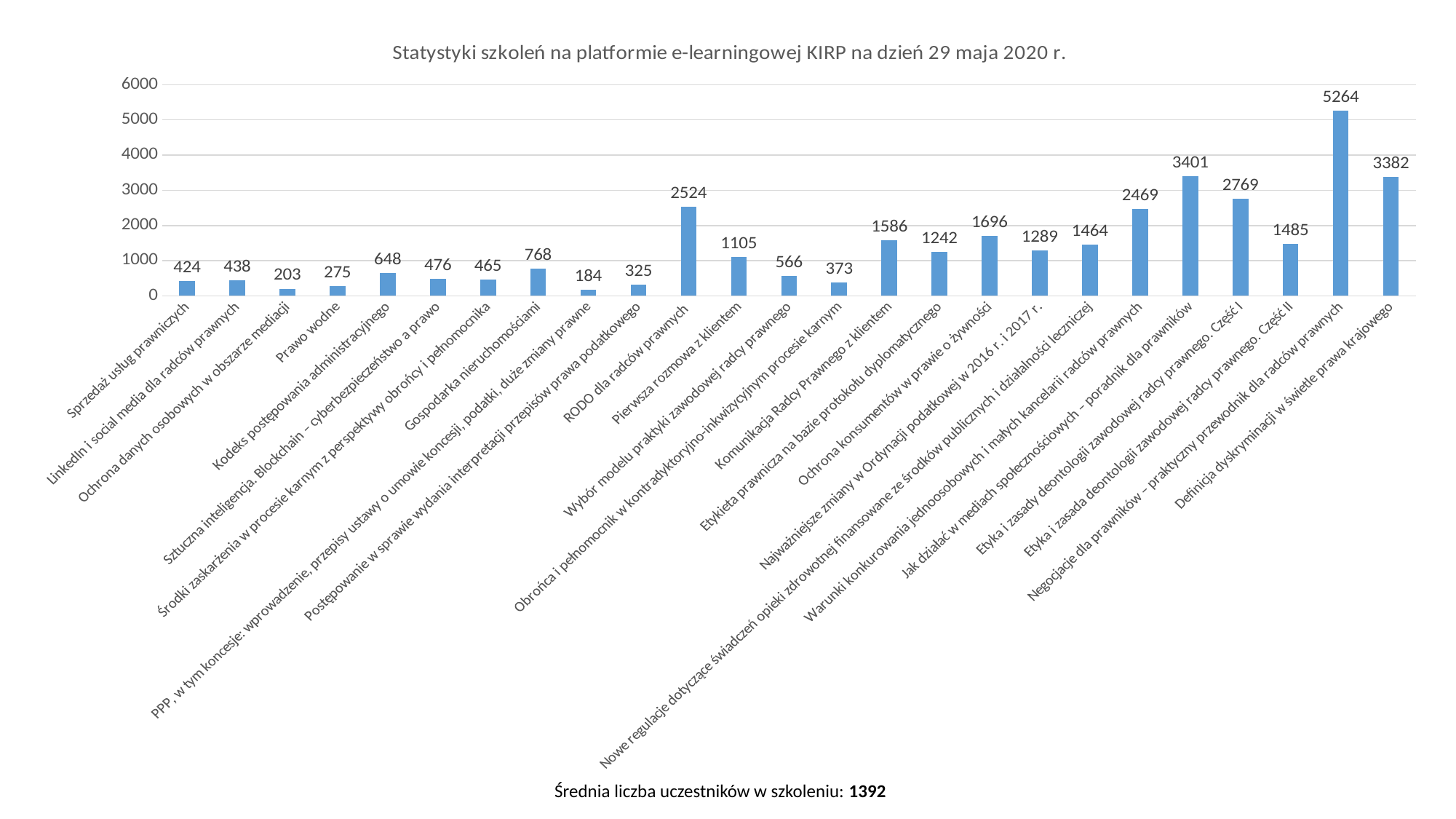
How many categories are shown on the chart? 25 What is the value for "RODO dla radców prawnych"? 2524 What is the difference between the values for "Jak działać w mediach społecznościowych – poradnik dla prawników" and "Definicja dyskryminacji w świetle prawa krajowego"? 19 What average number of participants per training is stated below the chart? 1392 Which category has the highest value? Negocjacje dla prawników – praktyczny przewodnik dla radców prawnych Which is larger: the value for "Komunikacja Radcy Prawnego z klientem" or the value for "Ochrona konsumentów w prawie o żywności"? Ochrona konsumentów w prawie o żywności What kind of chart is shown on the slide? bar chart What is the value for "Definicja dyskryminacji w świetle prawa krajowego"? 3382 Which category has the lowest value? PPP, w tym koncesje: wprowadzenie, przepisy ustawy o umowie koncesji, podatki, duże zmiany prawne Is the value for "Warunki konkurowania jednoosobowych i małych kancelarii radców prawnych" greater or less than 2000? greater What is the title of the chart? Statystyki szkoleń na platformie e-learningowej KIRP na dzień 29 maja 2020 r. What is the value for "Prawo wodne"? 275